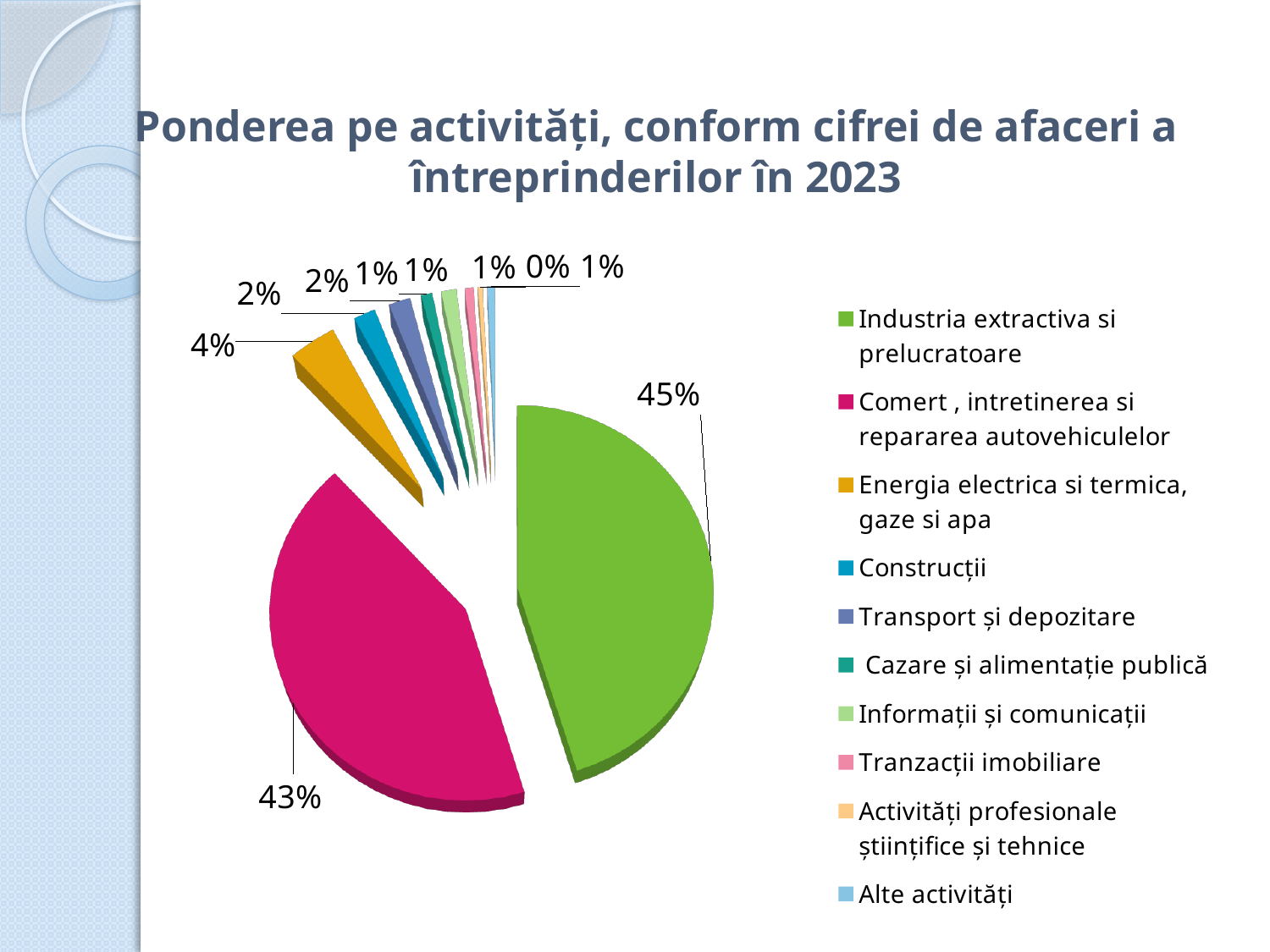
What kind of chart is shown on the slide? Pie chart What share of the pie does "Energia electrica si termica, gaze si apa" have? 4% Which category has the largest share of the pie? Industria extractiva si prelucratoare What is the difference in percentage points between the shares of "Industria extractiva si prelucratoare" and "Comert , intretinerea si repararea autovehiculelor"? 2 percentage points What share of the pie does "Activități profesionale științifice și tehnice" have? 0% How many categories does the legend of the pie chart list? 10 What share of the pie does "Industria extractiva si prelucratoare" have? 45% What is the title of the slide containing the pie chart? Ponderea pe activități, conform cifrei de afaceri a întreprinderilor în 2023 What share of the pie does "Alte activități" have? 1% What share of the pie does "Construcții" have? 2% Which category has the smallest share of the pie? Activități profesionale științifice și tehnice What share of the pie does "Comert , intretinerea si repararea autovehiculelor" have? 43%